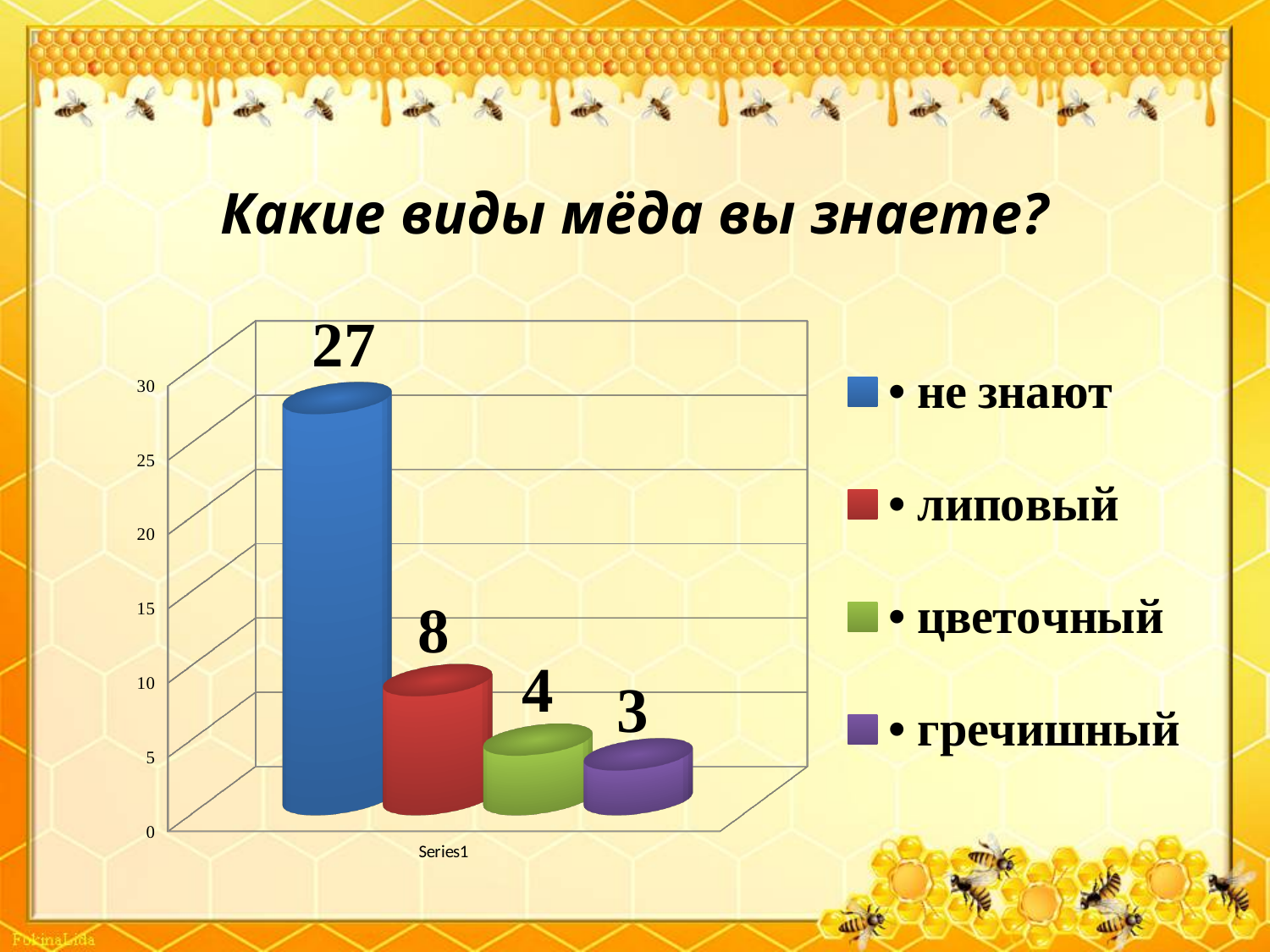
Which category has the highest value? не знают What is the value for «липовый»? 8 What kind of chart is shown on the slide? bar chart Which category has the lowest value? гречишный Is the value for «не знают» greater or less than 25? greater What is the value for «цветочный»? 4 Which is larger, the value for «цветочный» or the value for «гречишный»? цветочный What is the difference between the values for «не знают» and «липовый»? 19 What is the value for «гречишный»? 3 How many bars are plotted in the chart? 4 What is the title of the chart? Какие виды мёда вы знаете? What is the value for «не знают»? 27